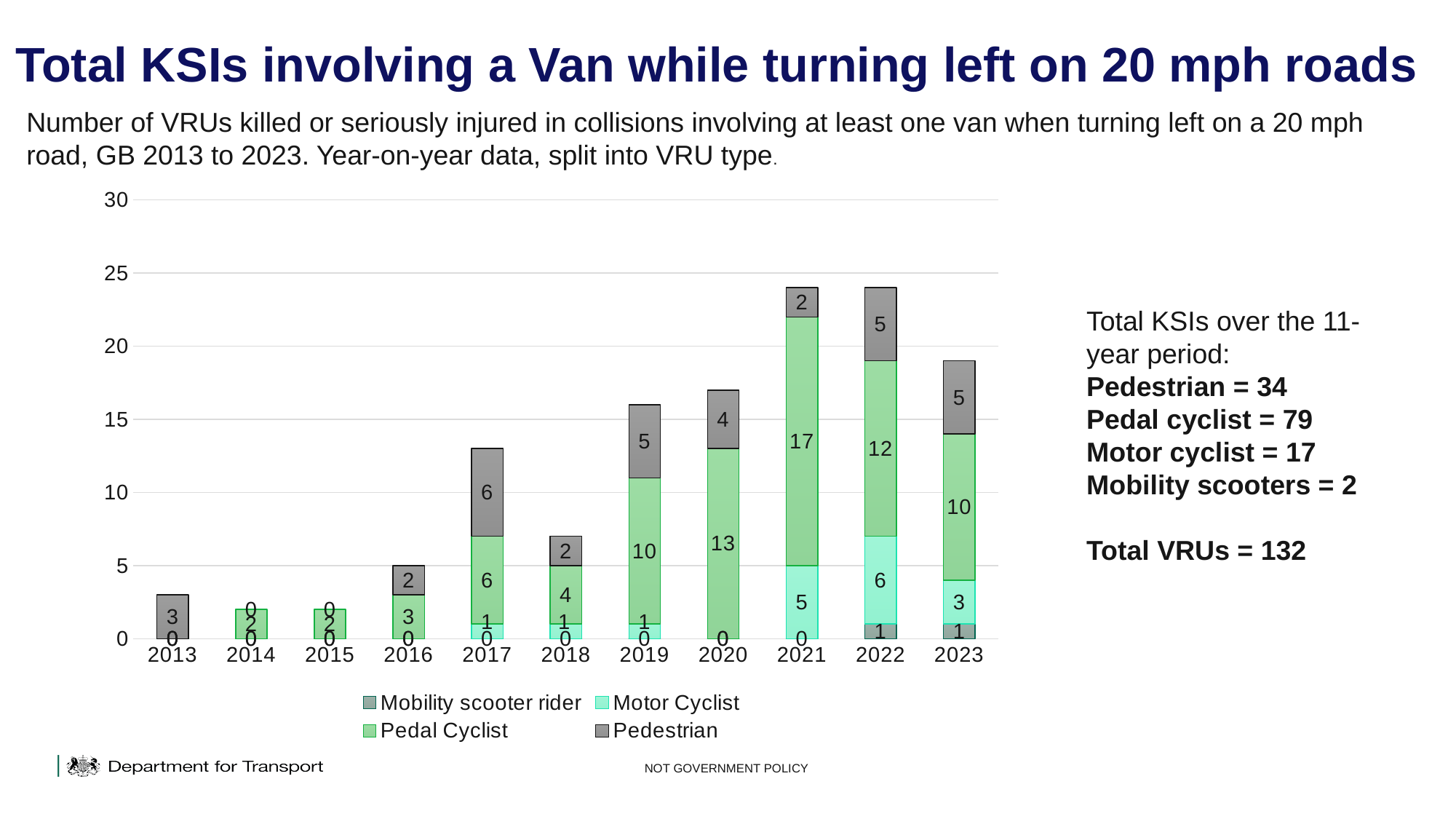
How many years are shown on the x axis? 11 Is the total of the stacked bar for 2022 greater or less than 20? greater What is the Pedestrian value for 2017? 6 What is the total of the stacked bar for 2023? 19 What is the Motor Cyclist value for 2022? 6 What is the total of the stacked bar for 2017? 13 Which is larger, the Pedestrian value for 2019 or the Pedestrian value for 2020? 2019 How many series does the legend list? 4 In which year is the Pedal Cyclist value highest? 2021 What kind of chart is shown on the slide? Stacked bar chart What is the Pedal Cyclist value for 2021? 17 What is the difference between the Pedal Cyclist values for 2020 and 2019? 3